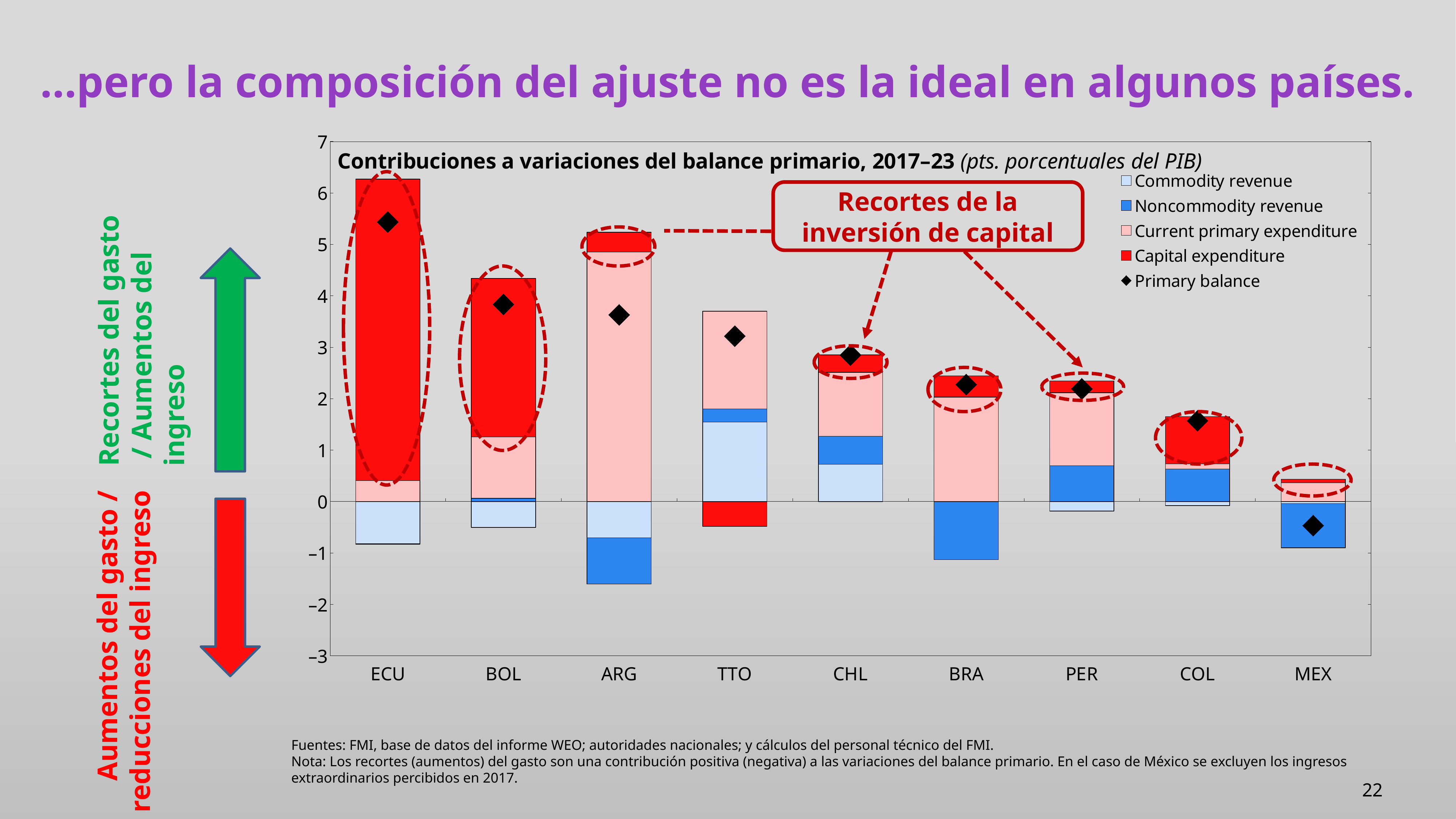
Is the primary balance marker for COL greater or less than 1? greater Which country has the lowest primary balance marker? MEX Is the primary balance marker for ECU greater or less than 5? greater Is the commodity revenue contribution for TTO greater or less than 1? greater Which country has the highest primary balance marker? ECU Which country has the larger capital expenditure contribution, ECU or BOL? ECU How many countries are shown on the x axis of the chart? 9 What kind of chart is shown on the slide? Stacked bar chart How many entries does the chart's legend list? 5 What is the title of the chart? Contribuciones a variaciones del balance primario, 2017–23 (pts. porcentuales del PIB)